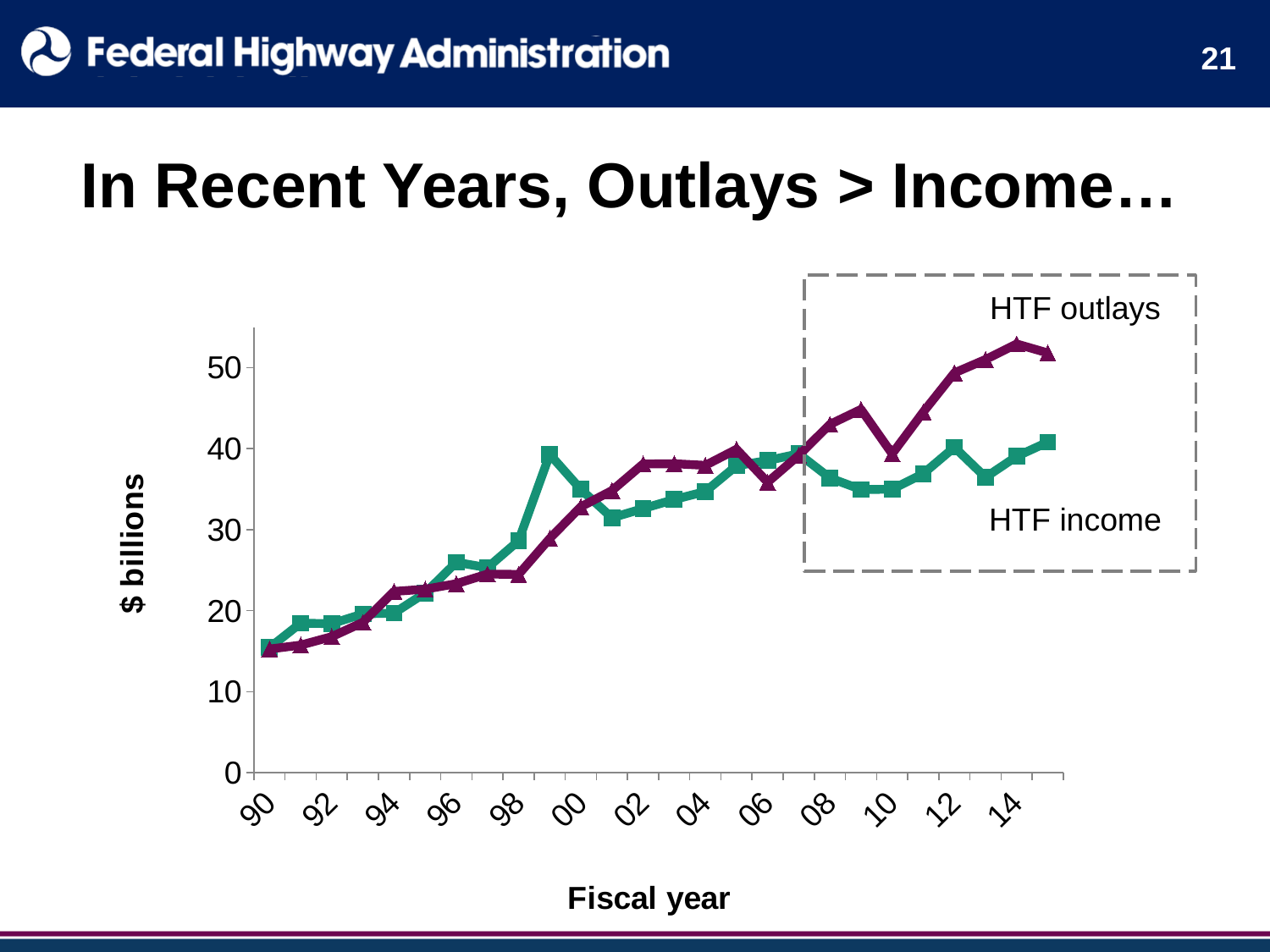
Does HTF outlays generally rise or fall from fiscal year 90 to fiscal year 14? rise Is the value for HTF outlays in fiscal year 14 greater or less than 50? greater Is the value for HTF outlays in fiscal year 90 greater or less than 20? less Is the value for HTF outlays in fiscal year 12 greater or less than 40? greater How many data series are plotted on the chart? 2 What are the names of the two series plotted on the chart? HTF outlays and HTF income What kind of chart is shown on the slide? line chart Which series reaches the highest value on the chart? HTF outlays In fiscal year 14, which is larger, HTF outlays or HTF income? HTF outlays How many fiscal year labels are shown along the x axis? 13 What is the label on the vertical axis of the chart? $ billions